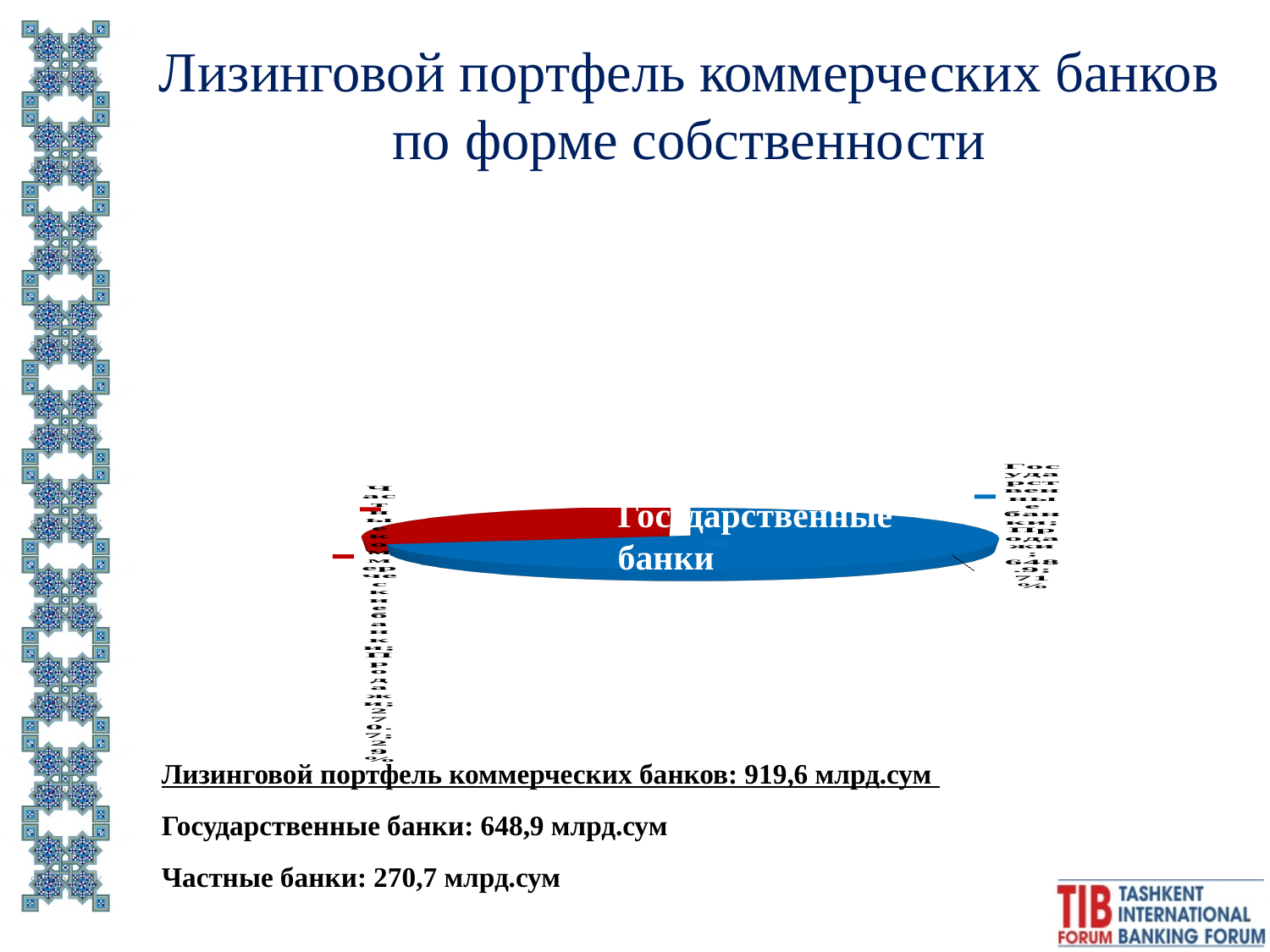
What is the title of the slide containing the chart? Лизинговой портфель коммерческих банков по форме собственности What colour is the slice for Государственные банки? blue By how much does the value for Государственные банки exceed the value for Частные банки? 378,2 млрд.сум What is the leasing portfolio value for Частные банки? 270,7 млрд.сум How many slices does the pie chart have? 2 What kind of chart is shown on the slide? pie chart What is the leasing portfolio value for Государственные банки? 648,9 млрд.сум Which category has the smaller slice of the pie chart? Частные банки Which category has the larger slice of the pie chart? Государственные банки Is the value for Государственные банки larger or smaller than the value for Частные банки? larger What is the total leasing portfolio of commercial banks shown on the slide? 919,6 млрд.сум